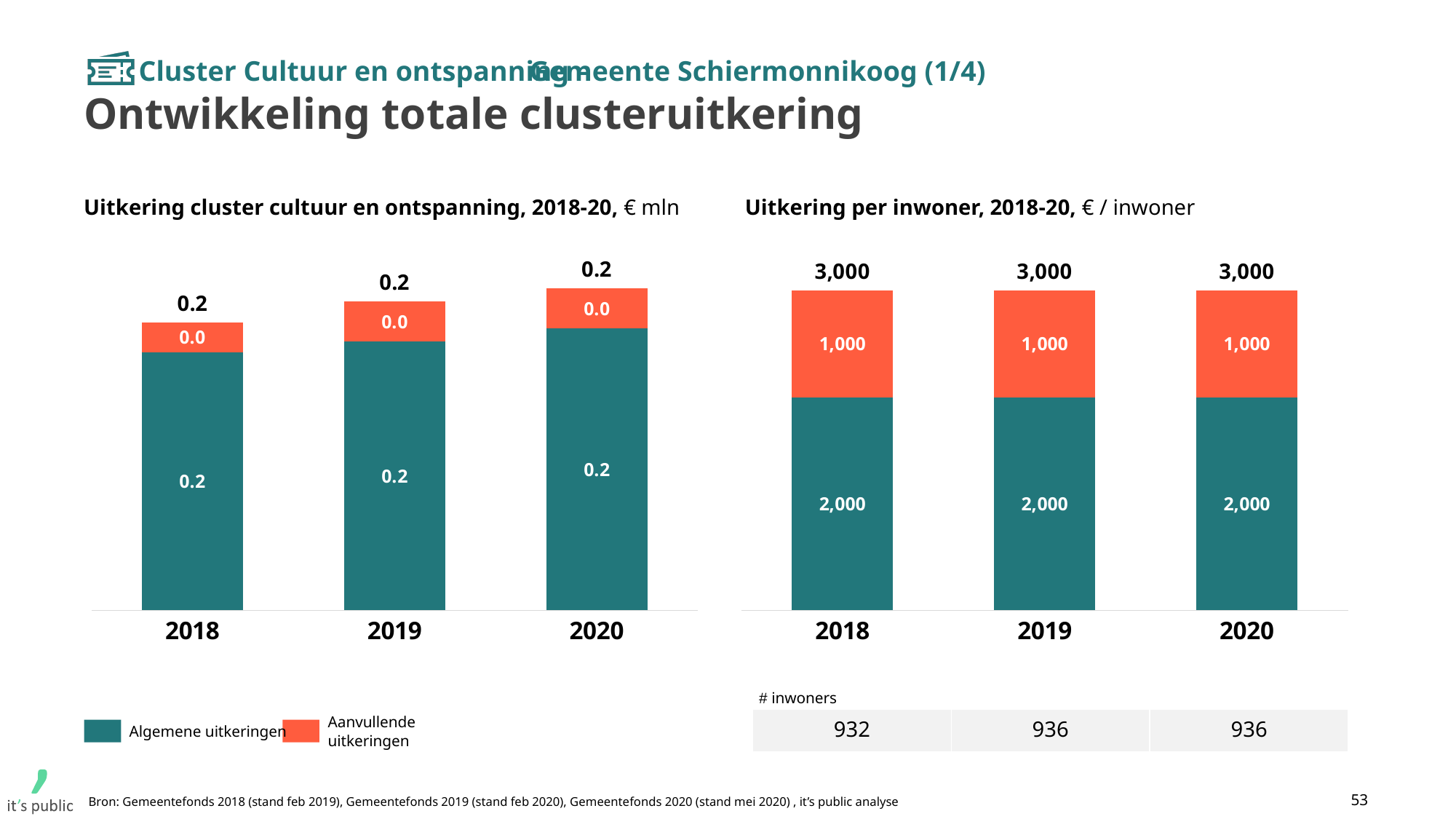
In the chart 'Uitkering per inwoner, 2018-20', which is larger in 2019: Algemene uitkeringen or Aanvullende uitkeringen? Algemene uitkeringen What kind of chart is 'Uitkering per inwoner, 2018-20'? Stacked bar chart In the chart 'Uitkering per inwoner, 2018-20', what is the value of Aanvullende uitkeringen for 2020? 1,000 In the chart 'Uitkering per inwoner, 2018-20', what is the difference between Algemene uitkeringen and Aanvullende uitkeringen in 2020? 1,000 How many series does the legend list for the charts on the slide? 2 Which series is shown in orange in the legend? Aanvullende uitkeringen In the chart 'Uitkering cluster cultuur en ontspanning, 2018-20', what is the value of Algemene uitkeringen for 2020? 0.2 In the chart 'Uitkering cluster cultuur en ontspanning, 2018-20', what is the total of the stacked bar for 2019? 0.2 How many years are shown on the x axis of the chart 'Uitkering cluster cultuur en ontspanning, 2018-20'? 3 In the chart 'Uitkering per inwoner, 2018-20', what is the total of the stacked bar for 2019? 3,000 In the chart 'Uitkering cluster cultuur en ontspanning, 2018-20', what is the value of Aanvullende uitkeringen for 2018? 0.0 In the chart 'Uitkering per inwoner, 2018-20', what is the value of Algemene uitkeringen for 2018? 2,000